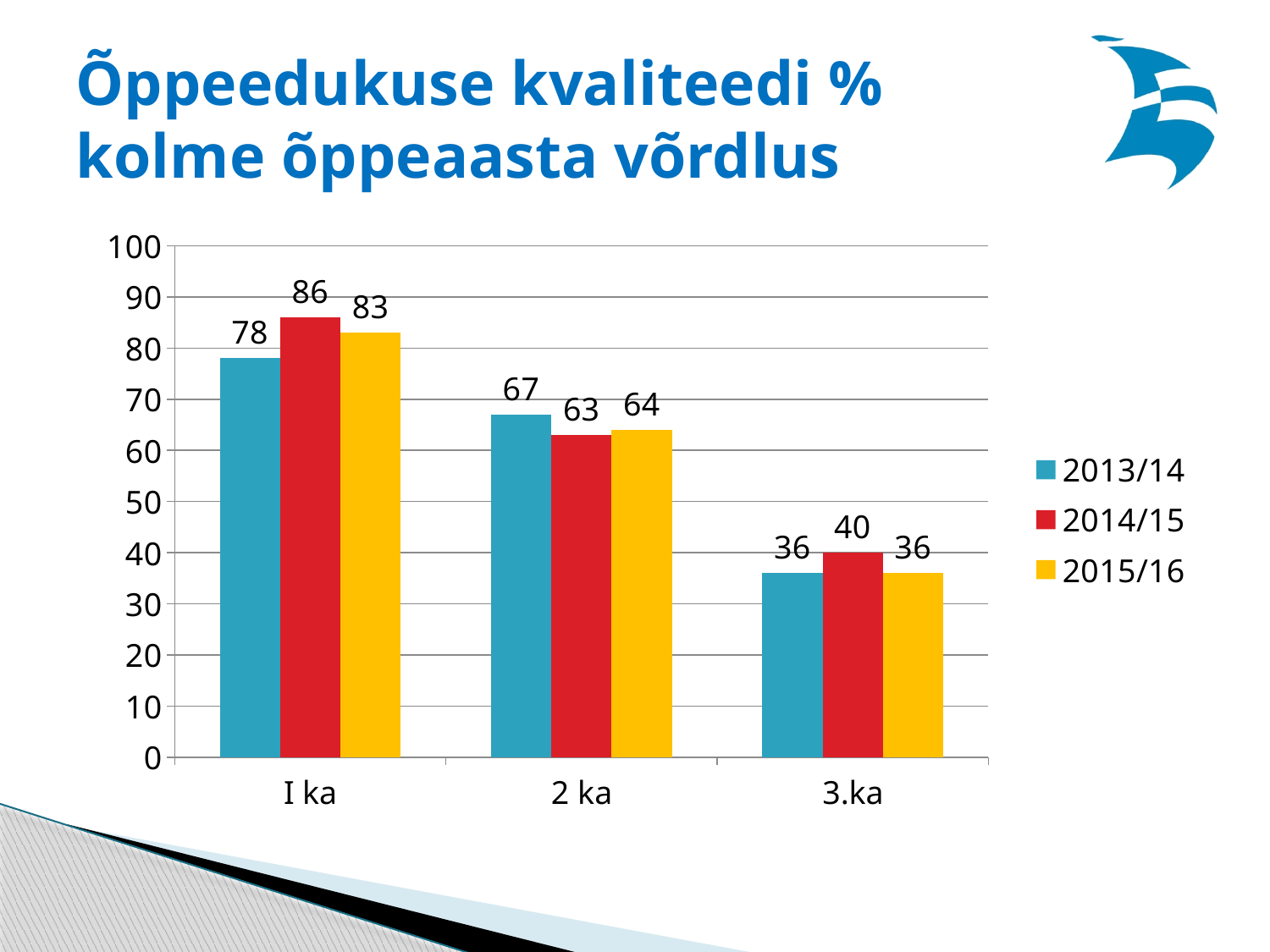
Do the values for the 2015/16 series rise or fall from I ka to 3.ka? fall In the 2 ka category, which is larger: the 2013/14 value or the 2014/15 value? 2013/14 What is the difference between the 2013/14 and 2015/16 values in the 2 ka category? 3 How many categories are shown on the x axis? 3 What is the value for 2015/16 in the 3.ka category? 36 What is the value for 2013/14 in the 2 ka category? 67 What is the value for 2014/15 in the I ka category? 86 How many series does the legend list? 3 What kind of chart is shown on the slide? bar chart Which category has the highest value for the 2013/14 series? I ka What is the difference between the 2014/15 and 2013/14 values in the I ka category? 8 Which category has the lowest value for the 2014/15 series? 3.ka